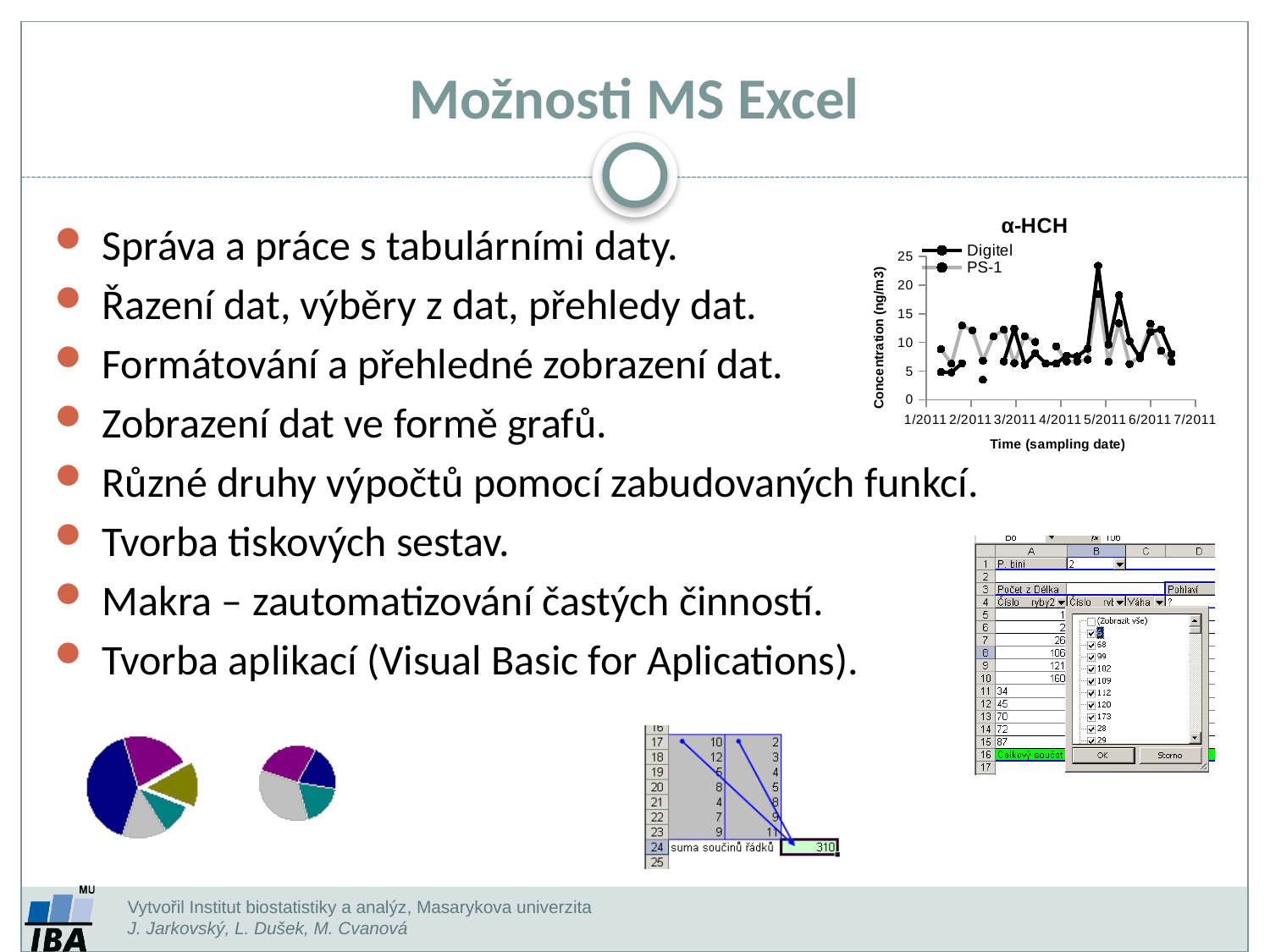
What is the highest tick value shown on the y axis of the α-HCH chart? 25 In the α-HCH chart, is the highest value of the PS-1 series greater or less than 15? greater In the α-HCH chart, is the first Digitel value at 1/2011 greater or less than 10? less In the α-HCH chart, which series reaches the higher peak around 5/2011, Digitel or PS-1? Digitel What kind of charts are the two charts in the lower left of the slide? pie charts What kind of chart is the α-HCH chart in the upper right of the slide? line chart In the α-HCH chart, is the lowest PS-1 value greater or less than 5? greater How many date labels are shown on the x axis of the α-HCH chart? 7 How many series does the legend of the α-HCH chart list? 2 What are the two series named in the legend of the α-HCH chart? Digitel and PS-1 What is the title of the line chart in the upper right of the slide? α-HCH